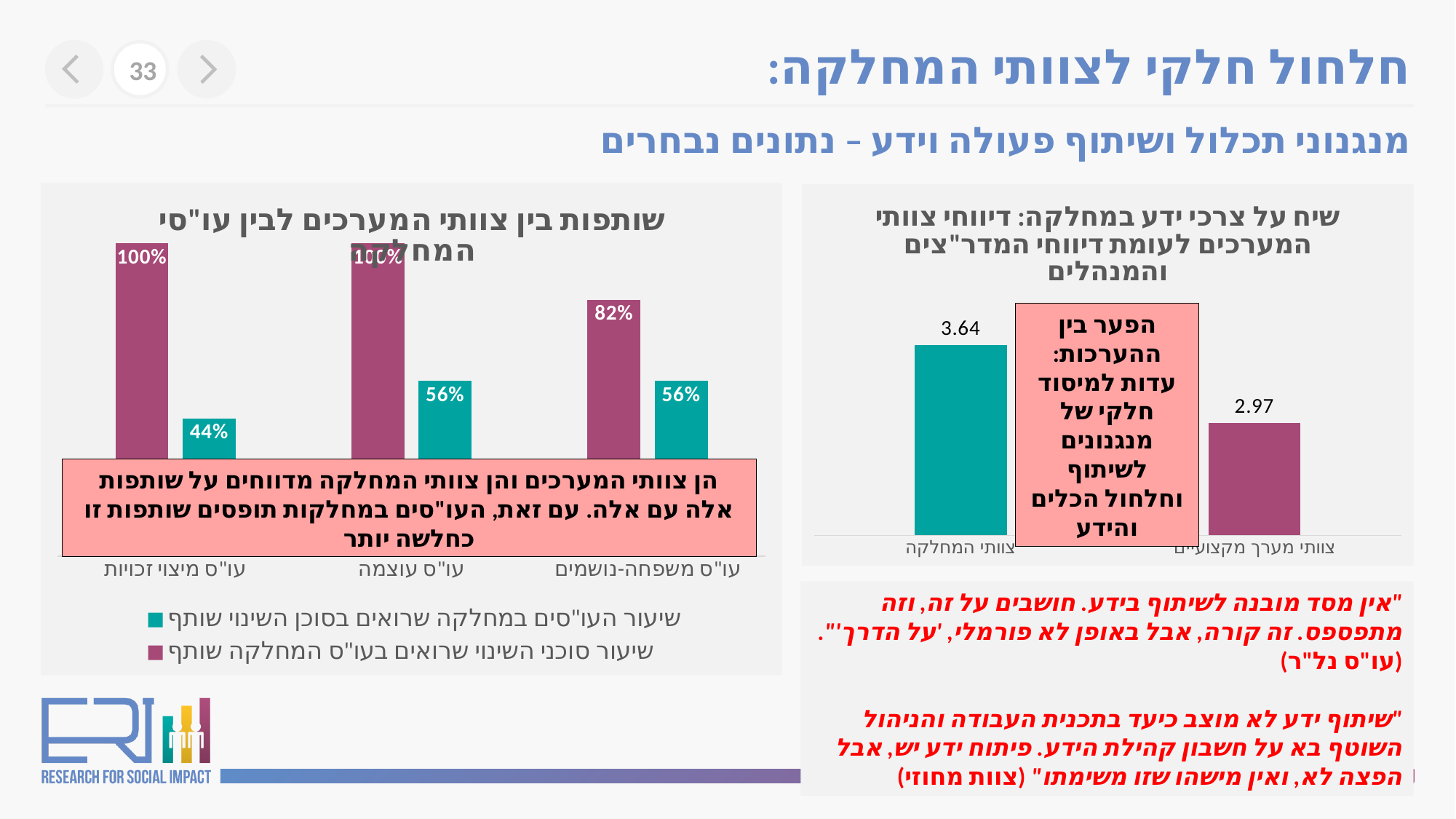
In the left chart, what is the value of the teal series (שיעור העו"סים במחלקה שרואים בסוכן השינוי שותף) for עו"ס מיצוי זכויות? 44% In the left chart, which category has the lowest value for the teal series? עו"ס מיצוי זכויות How many categories are shown on the x axis of the left chart? 3 In the right chart, which category has the higher value? צוותי המחלקה In the left chart, what is the difference between the purple and teal values for עו"ס מיצוי זכויות? 56% In the right chart, what is the value for צוותי המחלקה? 3.64 In the left chart, what is the value of the purple series (שיעור סוכני השינוי שרואים בעו"ס המחלקה שותף) for עו"ס משפחה-נושמים? 82% In the right chart, what is the value for צוותי מערך מקצועיים? 2.97 How many series does the legend of the left chart list? 2 In the left chart, for עו"ס משפחה-נושמים, which series has the larger value: the purple series or the teal series? the purple series (שיעור סוכני השינוי שרואים בעו"ס המחלקה שותף) What type of chart is the left chart? bar chart In the left chart, what is the value of the teal series for עו"ס עוצמה? 56%